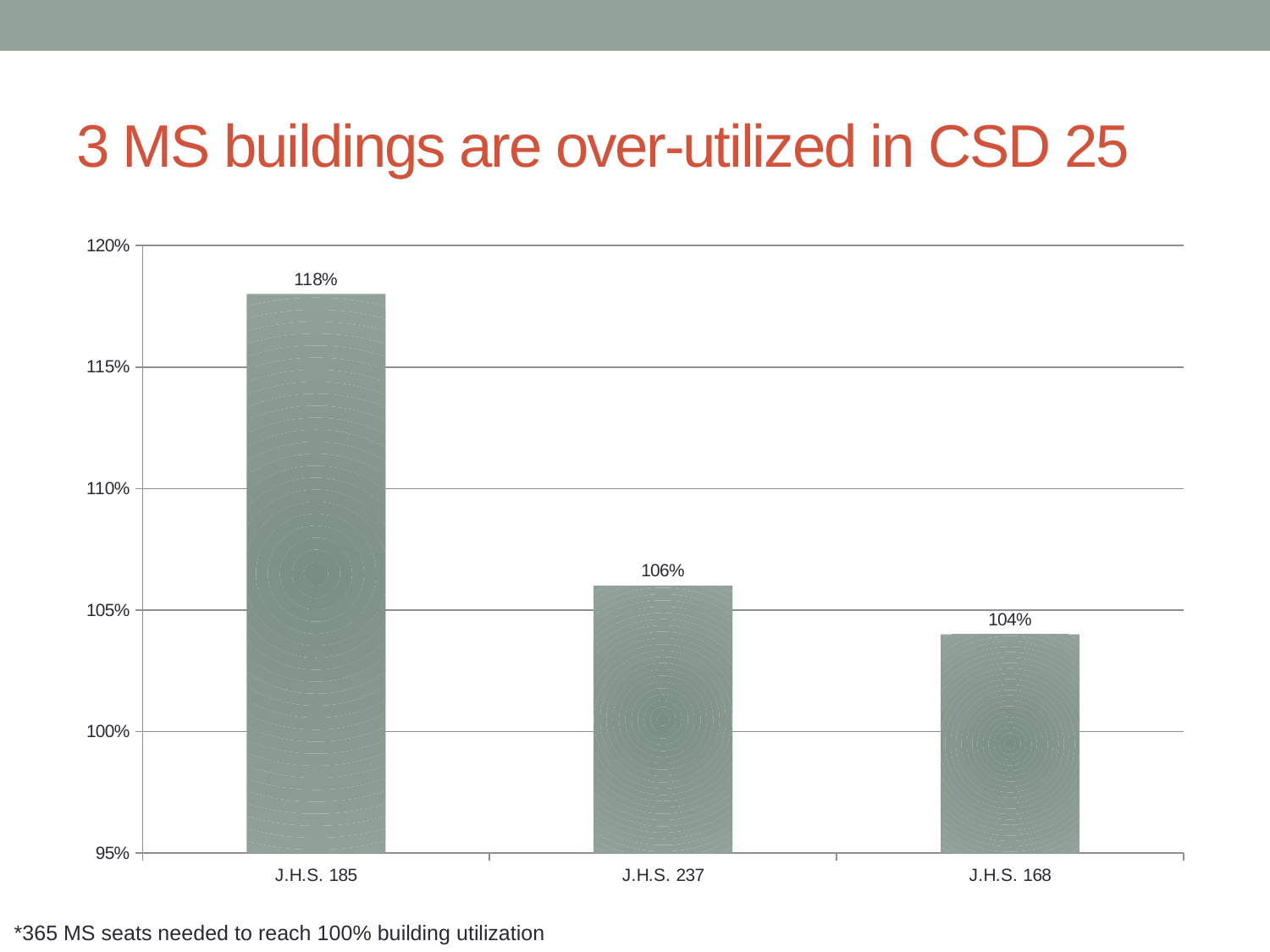
What is the utilization value for J.H.S. 168? 104% Which building has the highest utilization? J.H.S. 185 How many buildings are shown in the chart? 3 Do the values rise or fall from left to right across the x axis? fall What is the difference in utilization between J.H.S. 185 and J.H.S. 168? 14% What is the difference in utilization between J.H.S. 237 and J.H.S. 168? 2% Is the value for J.H.S. 185 greater or less than 115%? greater Which has a higher utilization, J.H.S. 237 or J.H.S. 168? J.H.S. 237 Which building has the lowest utilization? J.H.S. 168 What kind of chart is shown on the slide? bar chart What is the utilization value for J.H.S. 237? 106% What is the utilization value for J.H.S. 185? 118%